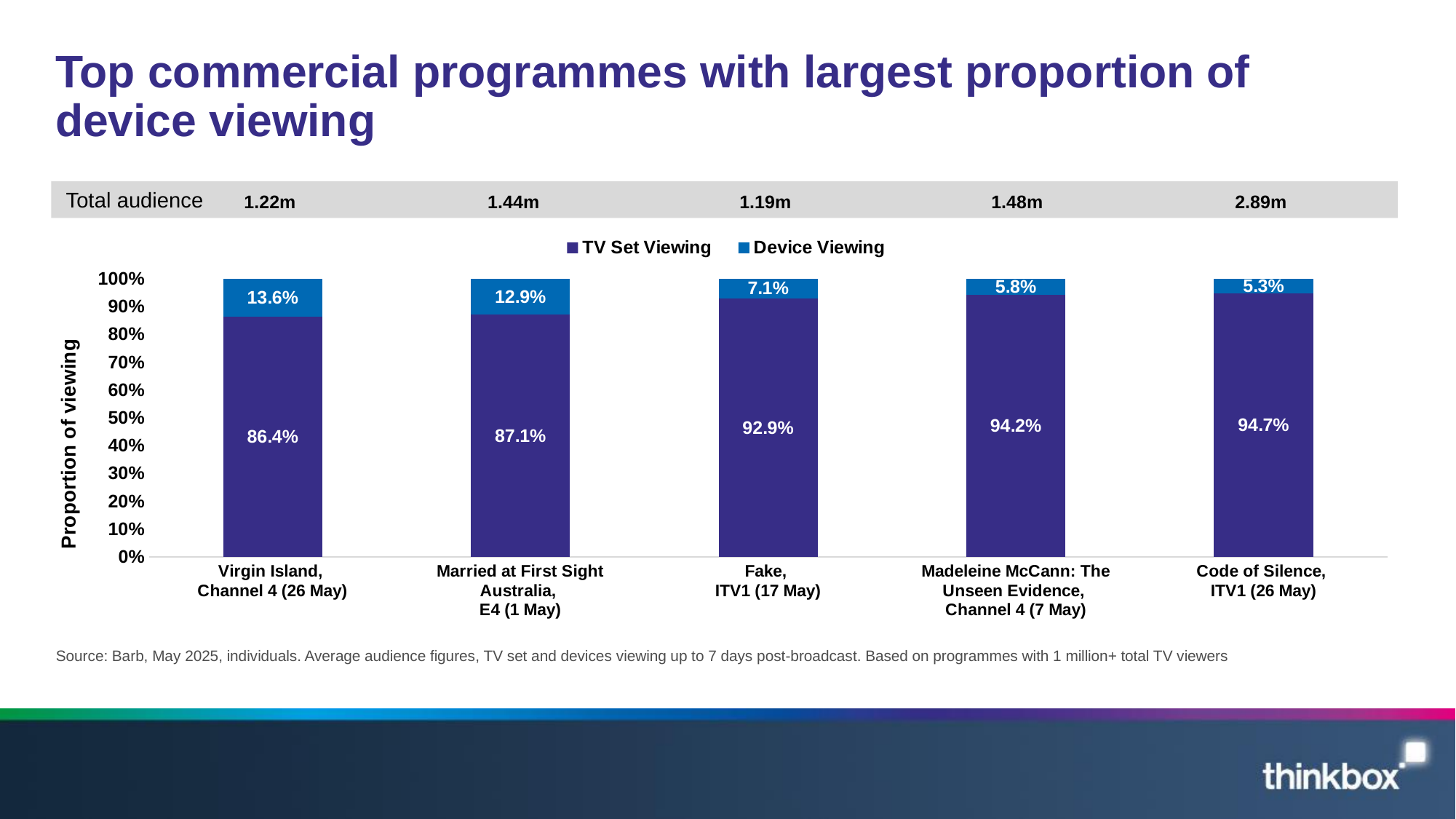
What is the total audience shown for Code of Silence, ITV1 (26 May)? 2.89m What is the difference between the Device Viewing proportions of Virgin Island and Married at First Sight Australia? 0.7% Which programme has the highest Device Viewing proportion? Virgin Island, Channel 4 (26 May) Which programme has the lowest TV Set Viewing proportion? Virgin Island, Channel 4 (26 May) Which has a larger Device Viewing proportion: Fake, ITV1 (17 May) or Madeleine McCann: The Unseen Evidence, Channel 4 (7 May)? Fake, ITV1 (17 May) What is the Device Viewing proportion for Virgin Island, Channel 4 (26 May)? 13.6% How many series does the legend list? 2 How many programmes are shown on the chart? 5 What kind of chart is shown on the slide? Stacked bar chart Does the Device Viewing proportion rise or fall moving from left to right across the programmes? Fall What is the Device Viewing proportion for Code of Silence, ITV1 (26 May)? 5.3% What is the TV Set Viewing proportion for Fake, ITV1 (17 May)? 92.9%